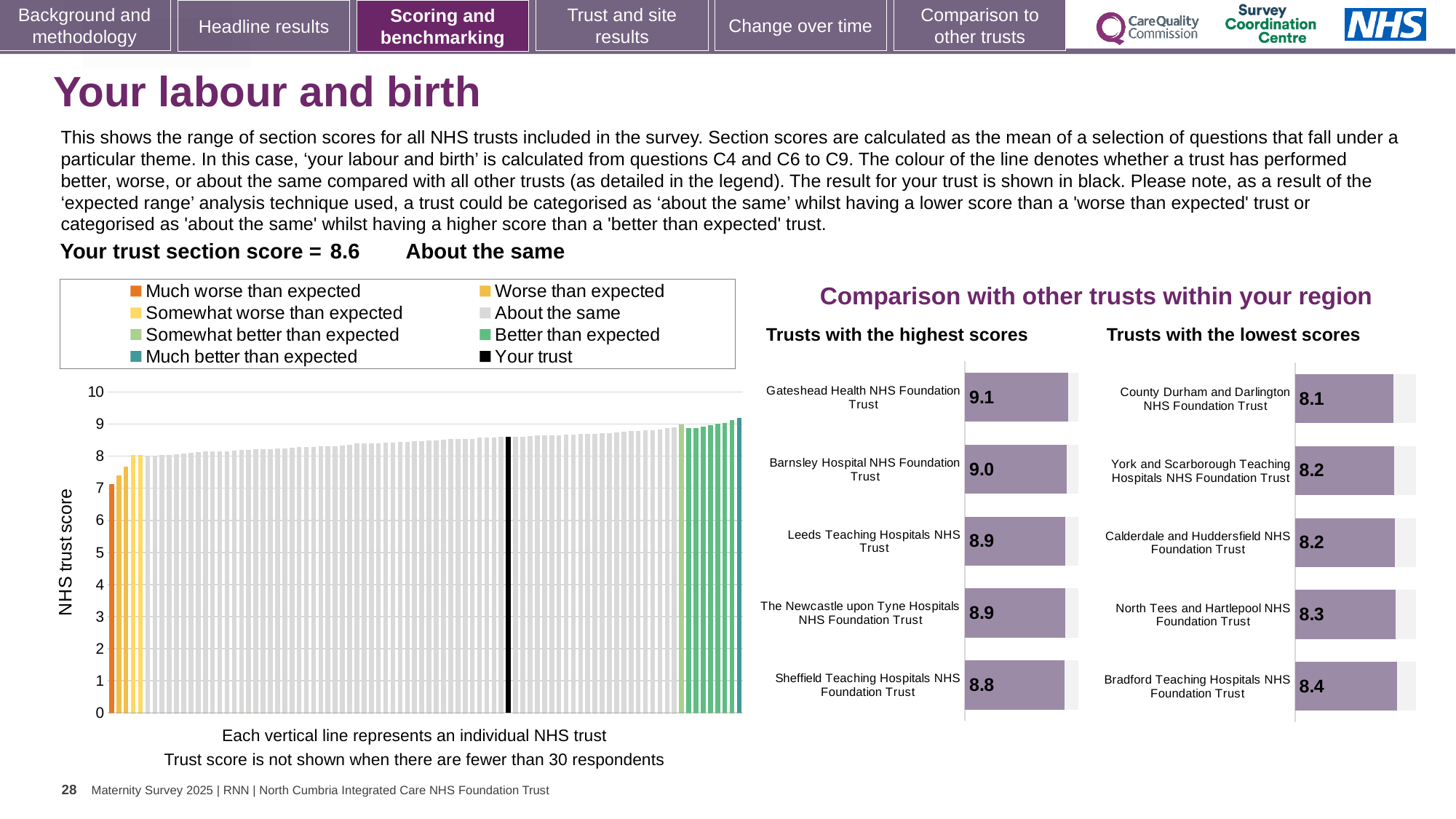
In the 'Trusts with the highest scores' chart, what is the difference between the scores of Gateshead Health NHS Foundation Trust and Sheffield Teaching Hospitals NHS Foundation Trust? 0.3 In the 'Trusts with the lowest scores' chart, which trust has the lowest score? County Durham and Darlington NHS Foundation Trust In the 'NHS trust score' chart on the left, do the bar values rise or fall from left to right? Rise What kind of chart is the 'NHS trust score' chart on the left of the slide? Bar chart Which has the larger score: Barnsley Hospital NHS Foundation Trust in the 'highest scores' chart or Bradford Teaching Hospitals NHS Foundation Trust in the 'lowest scores' chart? Barnsley Hospital NHS Foundation Trust In the 'Trusts with the lowest scores' chart, what is the score for North Tees and Hartlepool NHS Foundation Trust? 8.3 In the 'Trusts with the highest scores' chart, which trust has the highest score? Gateshead Health NHS Foundation Trust How many trusts are listed in the 'Trusts with the lowest scores' chart? 5 In the 'NHS trust score' chart on the left, is the value of the black bar (your trust) greater or less than 8? greater How many entries does the legend of the 'NHS trust score' chart on the left list? 8 In the 'Trusts with the highest scores' chart, what is the score for Gateshead Health NHS Foundation Trust? 9.1 In the 'Trusts with the lowest scores' chart, what is the difference between the scores of Bradford Teaching Hospitals NHS Foundation Trust and County Durham and Darlington NHS Foundation Trust? 0.3